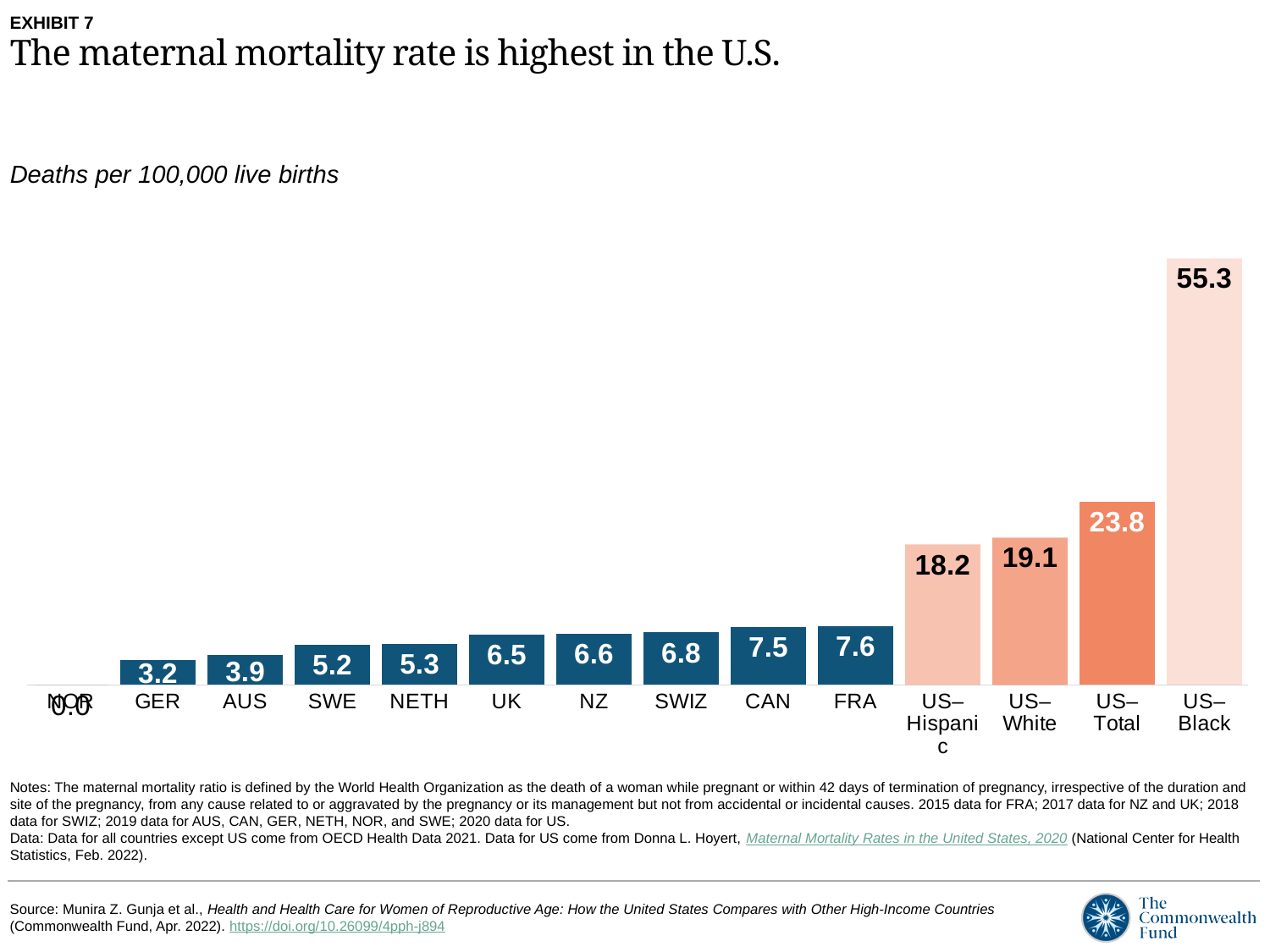
What is the difference between the values for FRA and GER? 4.4 What is the maternal mortality rate for US–Black? 55.3 What is the value shown for CAN? 7.5 What is the value shown for US–Hispanic? 18.2 Which is larger, the value for US–White or the value for US–Hispanic? US–White What unit is the chart measured in, according to the subtitle? Deaths per 100,000 live births How many categories are shown on the x axis? 14 What is the difference between the values for US–Black and US–Total? 31.5 Which category has the highest maternal mortality rate? US–Black What is the value shown for NETH? 5.3 What kind of chart is shown on the slide? Bar chart Which category has the lowest maternal mortality rate? NOR